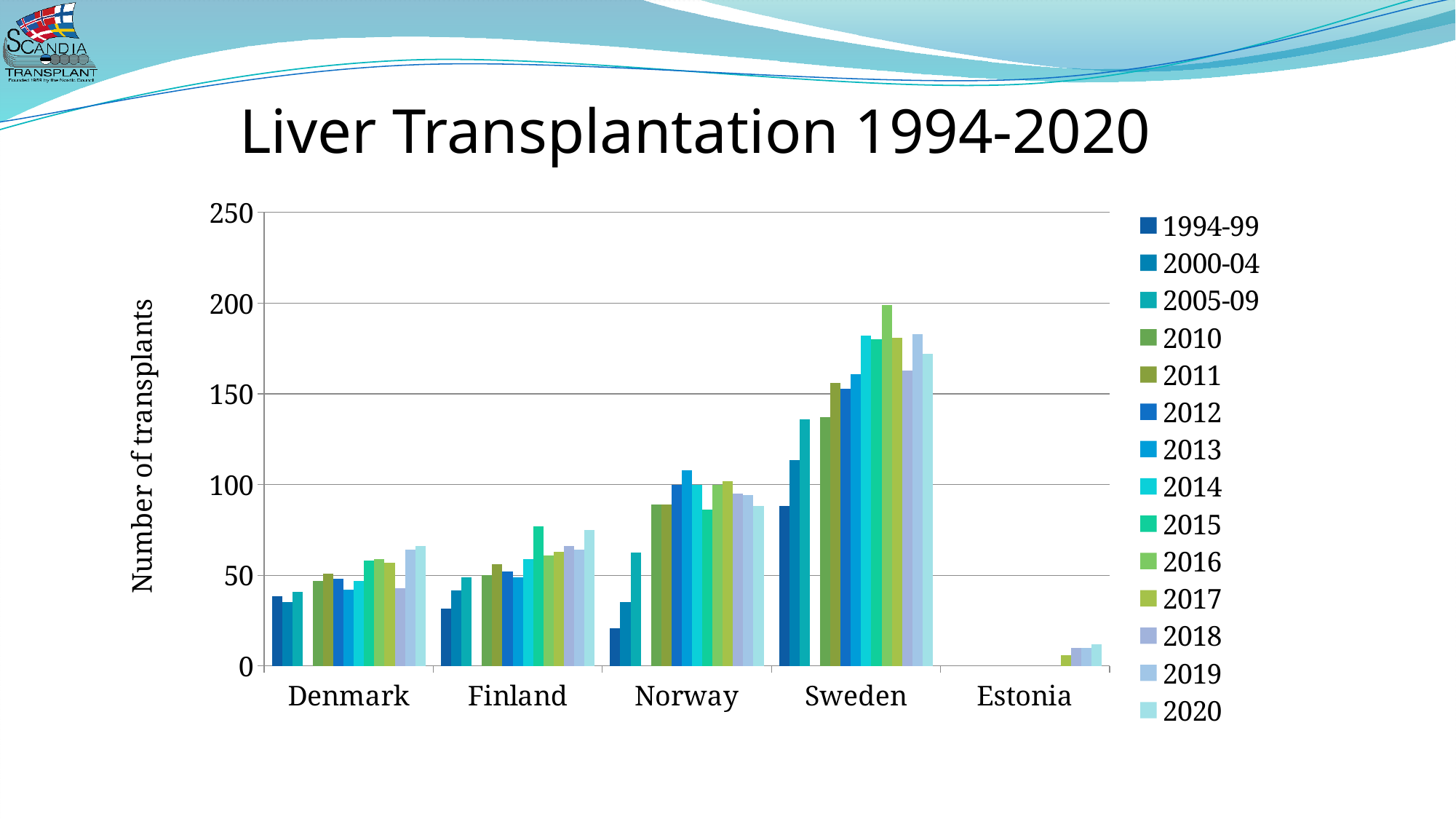
Is the value for Denmark in 2020 greater or less than 50? greater Is the value for Norway in 1994-99 greater or less than 50? less Is the value for Sweden in 1994-99 greater or less than 100? less Which country has the highest number of liver transplants in the chart? Sweden Within Sweden, do the bars generally rise or fall from 1994-99 through 2017? rise What kind of chart is shown on the slide? bar chart How many series does the chart's legend list? 14 How many countries are shown on the x axis of the chart? 5 Which is larger, the value for Sweden in 2017 or the value for Norway in 2017? Sweden in 2017 Which country has the lowest number of liver transplants in the chart? Estonia What is the label on the chart's vertical axis? Number of transplants